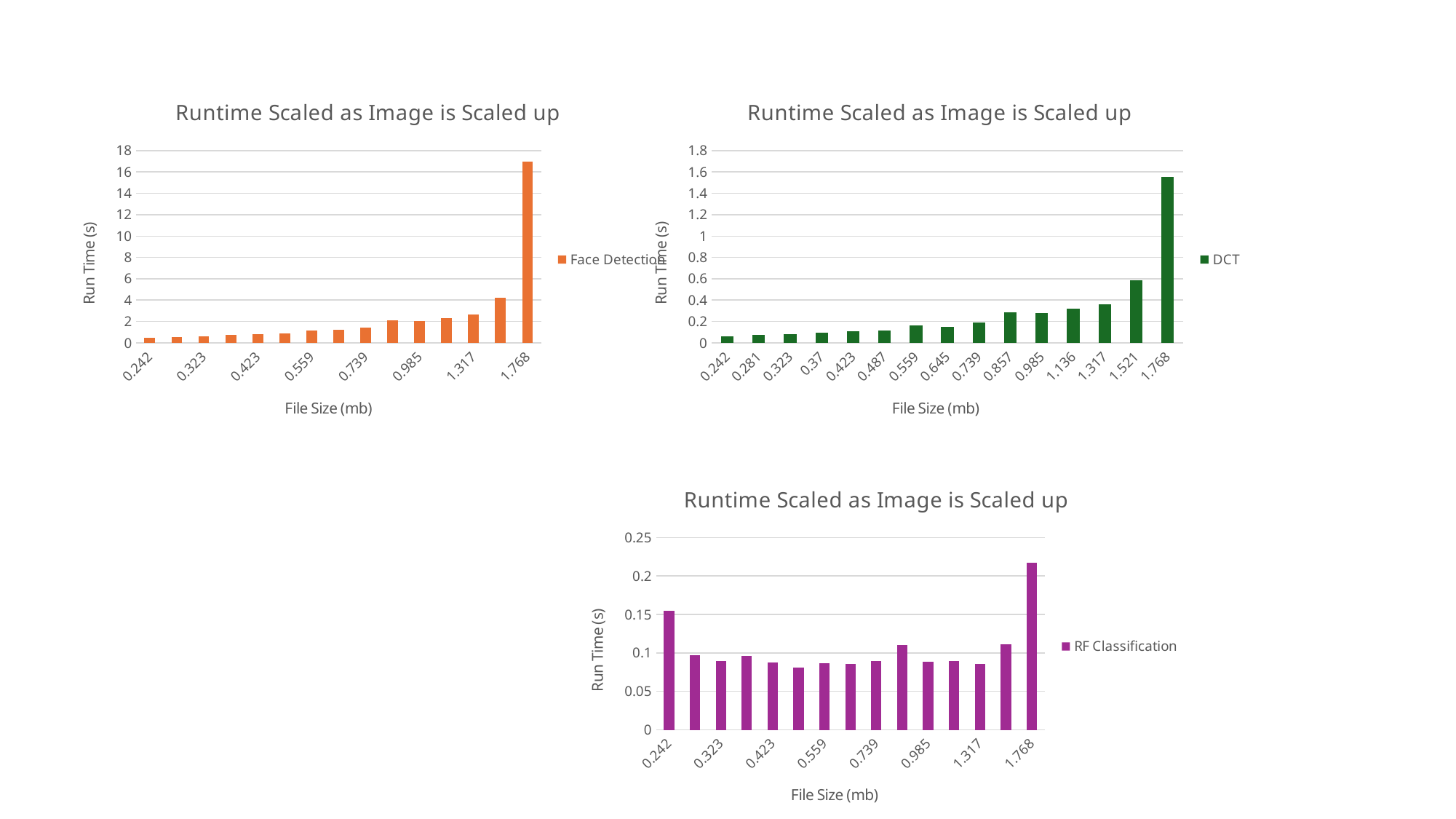
In the bottom chart (RF Classification), which has the larger run time: file size 0.242 or file size 0.323? 0.242 What series name does the legend of the top-right chart show? DCT In the top-left chart (Face Detection), is the run time for file size 1.768 greater or less than 16? greater In the top-right chart (DCT), is the run time for file size 1.768 greater or less than 1.4? greater In the bottom chart (RF Classification), is the run time for file size 1.768 greater or less than 0.2? greater In the top-right chart (DCT), which file size has the highest run time? 1.768 How many bars are plotted in the top-right chart (DCT)? 15 What kind of chart is the top-left chart with the Face Detection legend? bar chart In the top-left chart (Face Detection), do run times generally rise or fall as file size increases along the x axis? rise In the top-right chart (DCT), which file size has the lowest run time? 0.242 In the bottom chart (RF Classification), which file size has the highest run time? 1.768